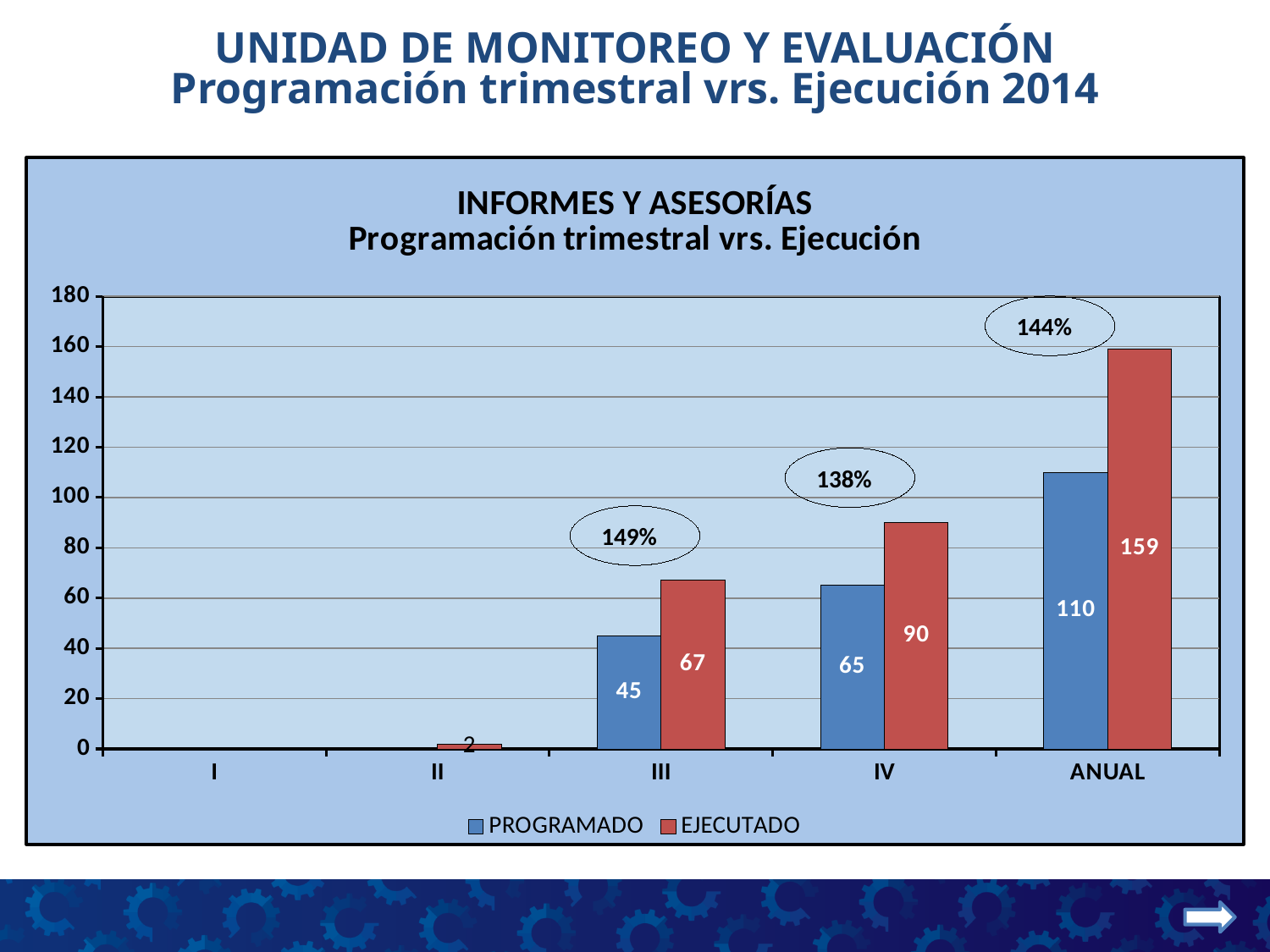
What is the difference between the EJECUTADO and PROGRAMADO values for category IV? 25 What percentage is shown in the circle above the ANUAL bars? 144% How many categories are shown on the x axis? 5 What is the EJECUTADO value for ANUAL? 159 How many series does the legend list? 2 What is the PROGRAMADO value for ANUAL? 110 What is the difference between the EJECUTADO and PROGRAMADO values for ANUAL? 49 Which category has the highest EJECUTADO value? ANUAL What kind of chart is shown on the slide? Bar chart Which is larger for category III, PROGRAMADO or EJECUTADO? EJECUTADO What is the PROGRAMADO value for category IV? 65 What is the EJECUTADO value for category III? 67